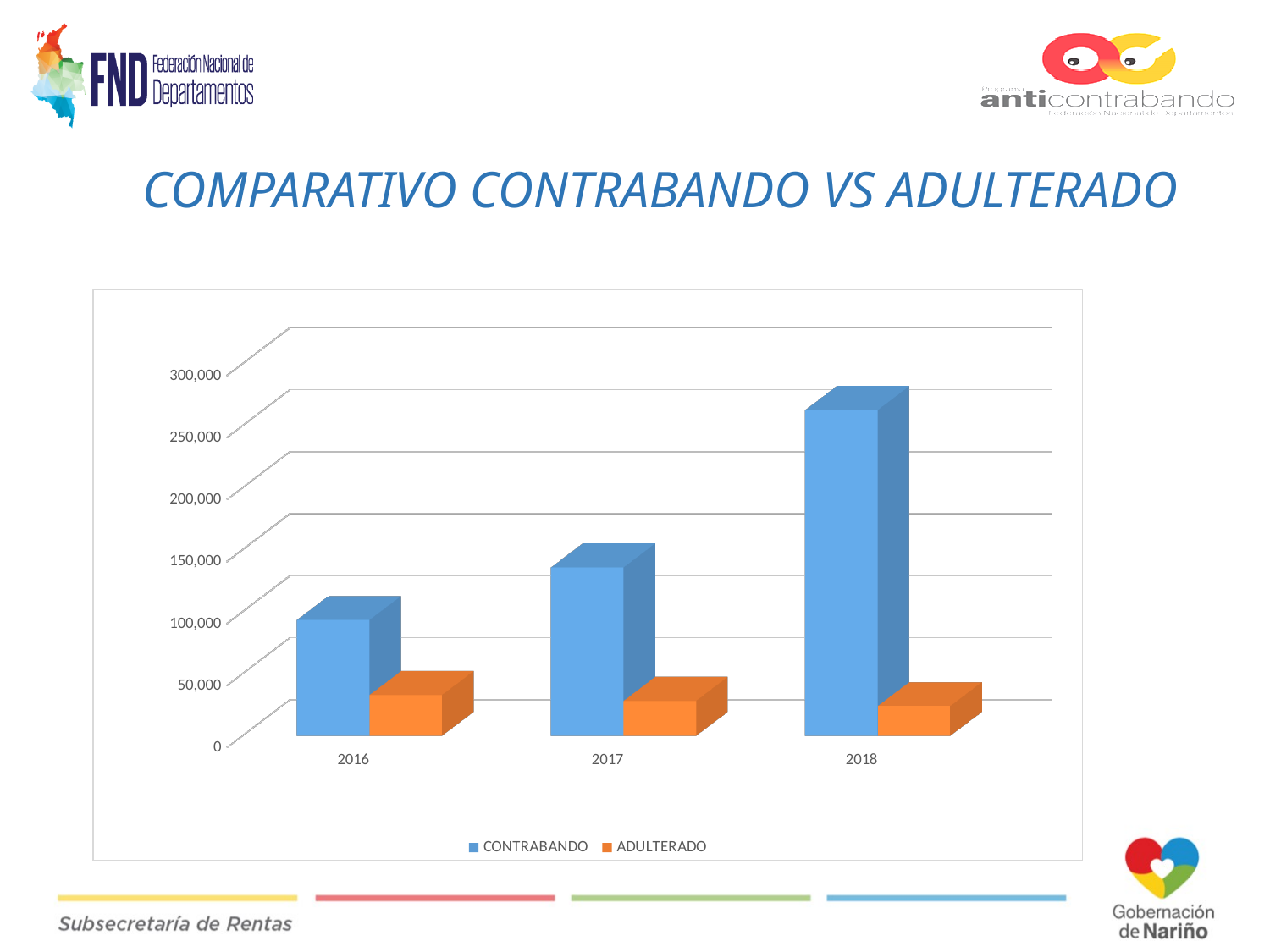
Is the ADULTERADO value for 2016 greater or less than 50,000? less How many years are shown on the x axis? 3 Is the CONTRABANDO value for 2018 greater or less than 250,000? greater Do the CONTRABANDO values rise or fall from 2016 to 2018? Rise Is the CONTRABANDO value for 2017 greater or less than 100,000? greater How many series does the legend list? 2 What is the title of the chart on the slide? COMPARATIVO CONTRABANDO VS ADULTERADO What kind of chart is shown on the slide? Bar chart In 2018, which is larger, CONTRABANDO or ADULTERADO? CONTRABANDO Which colour represents the ADULTERADO series? Orange In which year is the CONTRABANDO value lowest? 2016 In which year is the CONTRABANDO value highest? 2018